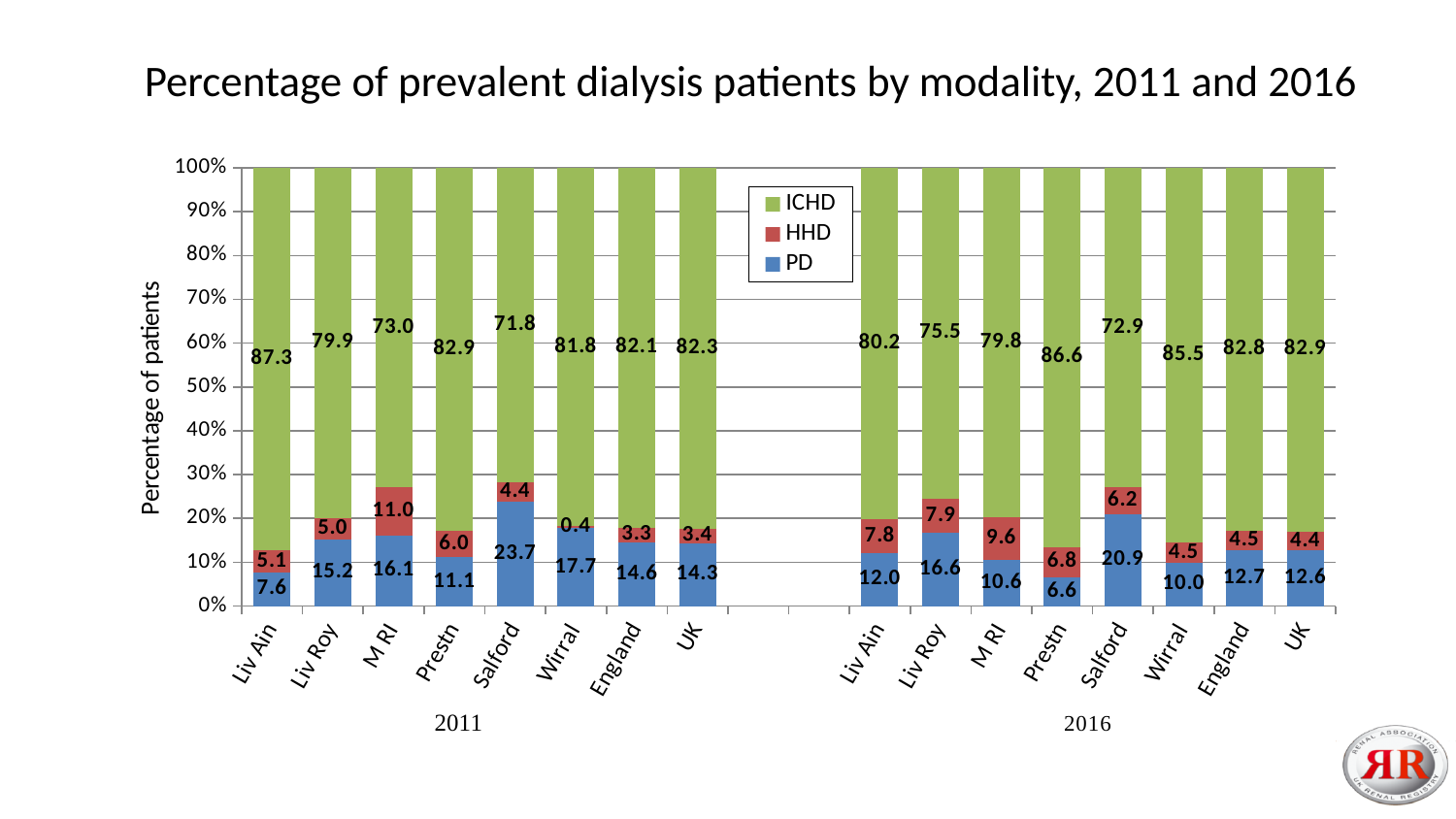
What is the label on the vertical axis? Percentage of patients What is the ICHD value for Liv Ain in 2011? 87.3 Which is larger, the HHD value for M RI in 2011 or the HHD value for M RI in 2016? M RI in 2011 How many series does the legend list? 3 Which series is shown in green in the legend? ICHD What kind of chart is shown on the slide? Stacked bar chart Which centre has the highest PD value in 2011? Salford What is the difference between the ICHD value for Prestn in 2016 and the ICHD value for Liv Roy in 2016? 11.1 What is the HHD value for Wirral in 2011? 0.4 Which centre has the lowest ICHD value in 2016? Salford What is the difference between the PD value for Salford in 2011 and in 2016? 2.8 What is the PD value for Salford in 2016? 20.9